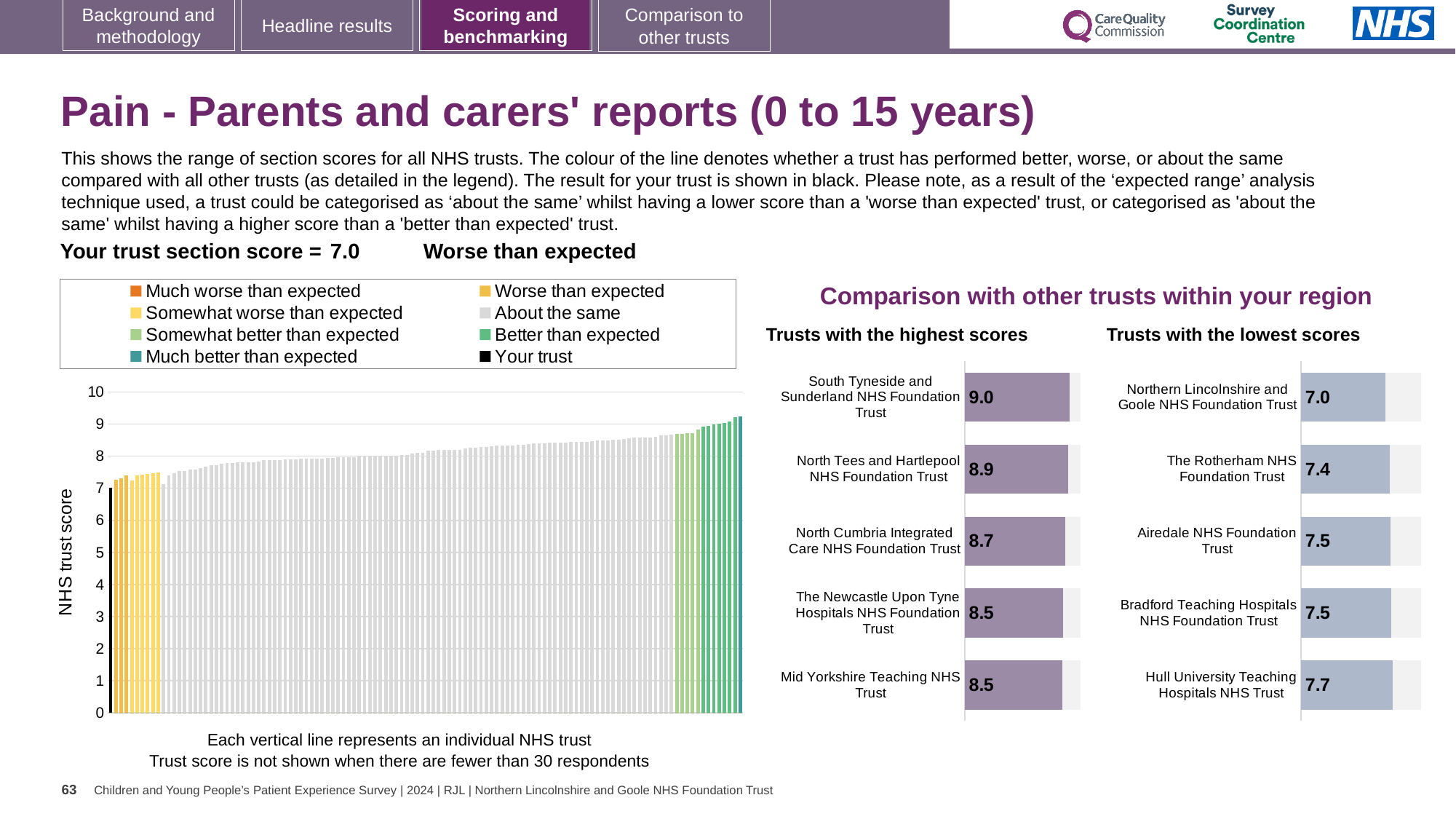
In the 'Trusts with the lowest scores' chart, what is the difference between the scores of Hull University Teaching Hospitals NHS Trust and Northern Lincolnshire and Goole NHS Foundation Trust? 0.7 In the 'NHS trust score' chart, do the bar heights rise or fall from left to right? rise In the 'Trusts with the lowest scores' chart, which trust has the lowest score? Northern Lincolnshire and Goole NHS Foundation Trust What kind of chart is the large chart on the left with the y-axis labelled 'NHS trust score'? bar chart How many entries does the legend above the 'NHS trust score' chart list? 8 In the 'NHS trust score' chart, is the value of the black 'Your trust' bar greater or less than 8? less In the 'Trusts with the lowest scores' chart, what is the score for The Rotherham NHS Foundation Trust? 7.4 In the 'Trusts with the lowest scores' chart, which has the larger score: The Rotherham NHS Foundation Trust or Hull University Teaching Hospitals NHS Trust? Hull University Teaching Hospitals NHS Trust In the 'Trusts with the highest scores' chart, what is the difference between the scores of South Tyneside and Sunderland NHS Foundation Trust and Mid Yorkshire Teaching NHS Trust? 0.5 In the 'Trusts with the highest scores' chart, how many trusts are shown? 5 In the 'Trusts with the highest scores' chart, which trust has the highest score? South Tyneside and Sunderland NHS Foundation Trust In the 'Trusts with the highest scores' chart, what is the score for South Tyneside and Sunderland NHS Foundation Trust? 9.0